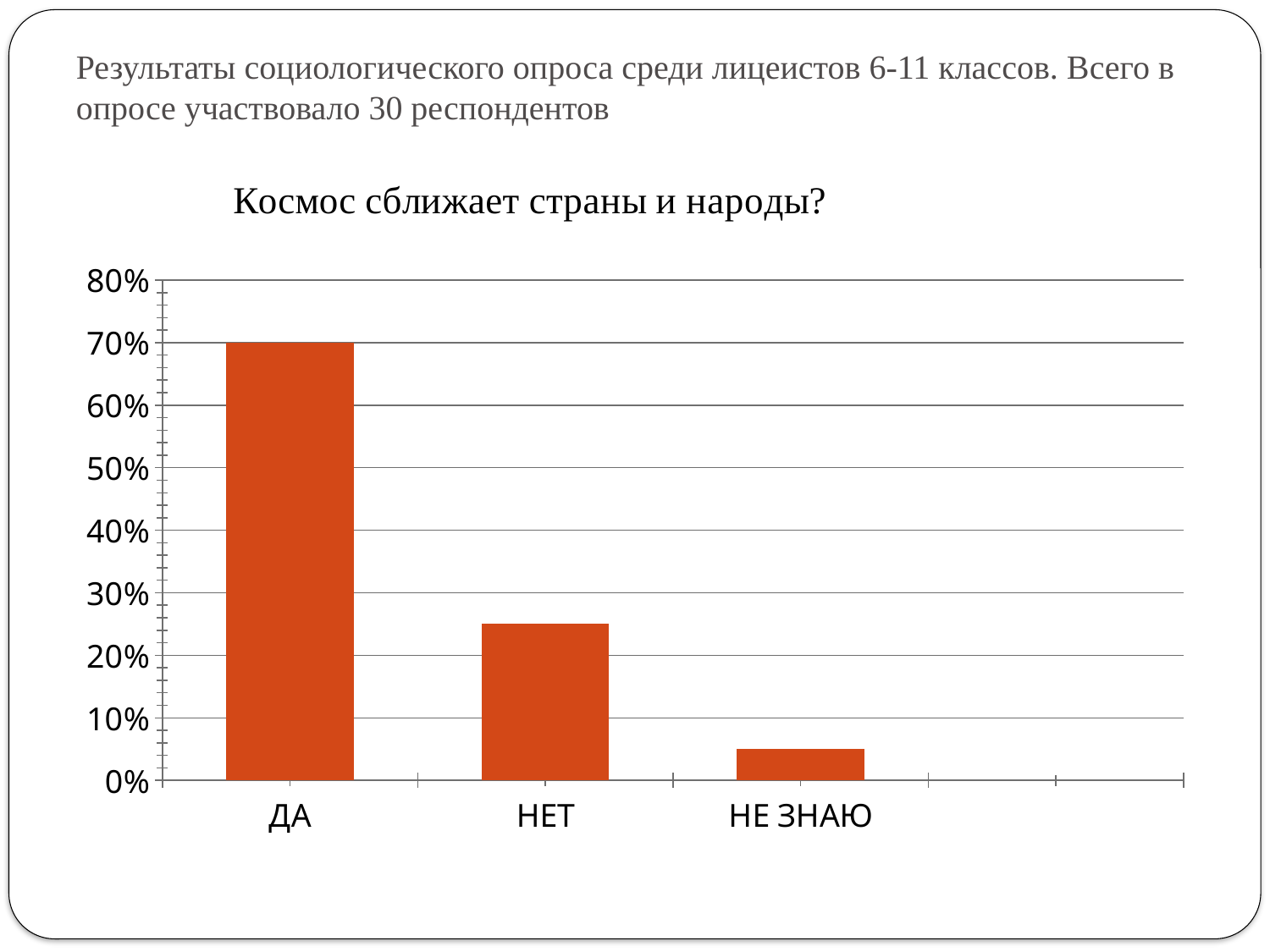
How many categories are shown on the x axis of the chart? 3 Which category has the lowest value? НЕ ЗНАЮ Do the values rise or fall from left to right along the x axis? fall What kind of chart is shown on the slide? bar chart Which is larger, the value for ДА or the value for НЕТ? ДА Is the value for НЕТ greater or less than 20%? greater Which category has the highest value? ДА Is the value for НЕТ greater or less than 30%? less Is the value for НЕ ЗНАЮ greater or less than 10%? less What is the title of the chart? Космос сближает страны и народы? Which is larger, the value for НЕТ or the value for НЕ ЗНАЮ? НЕТ What is the value for ДА? 70%